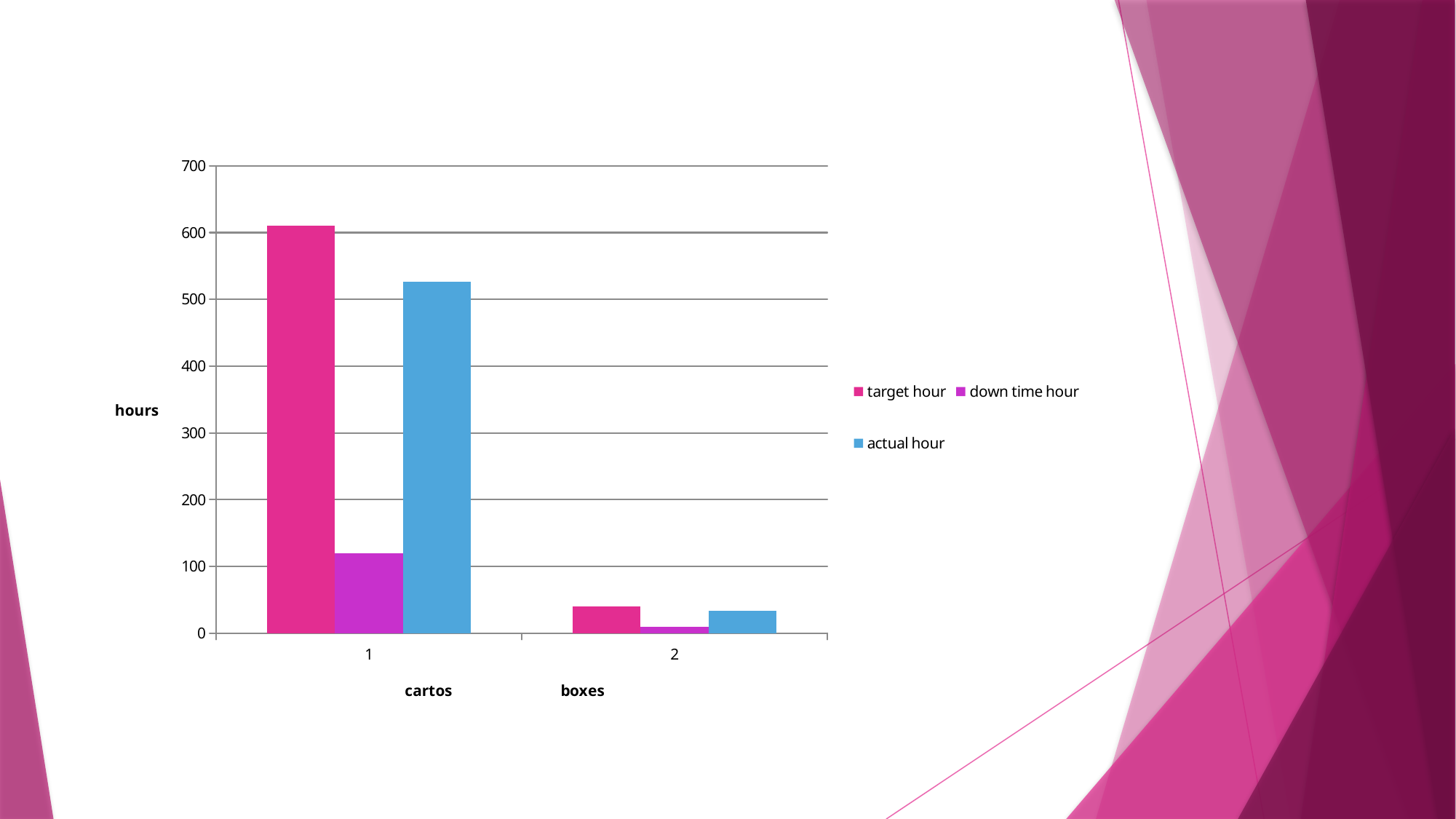
How many categories are shown on the x axis? 2 What is the label on the vertical axis? hours Which series has the lowest bar for category 2? down time hour Is the target hour value for category 1 greater or less than 500? greater Is the target hour value for category 2 greater or less than 100? less Is the actual hour value for category 1 greater or less than 400? greater Which series has the highest bar for category 1? target hour What kind of chart is shown on the slide? bar chart For category 1, which is larger: target hour or actual hour? target hour How many series does the legend list? 3 Which series has the lowest bar for category 1? down time hour